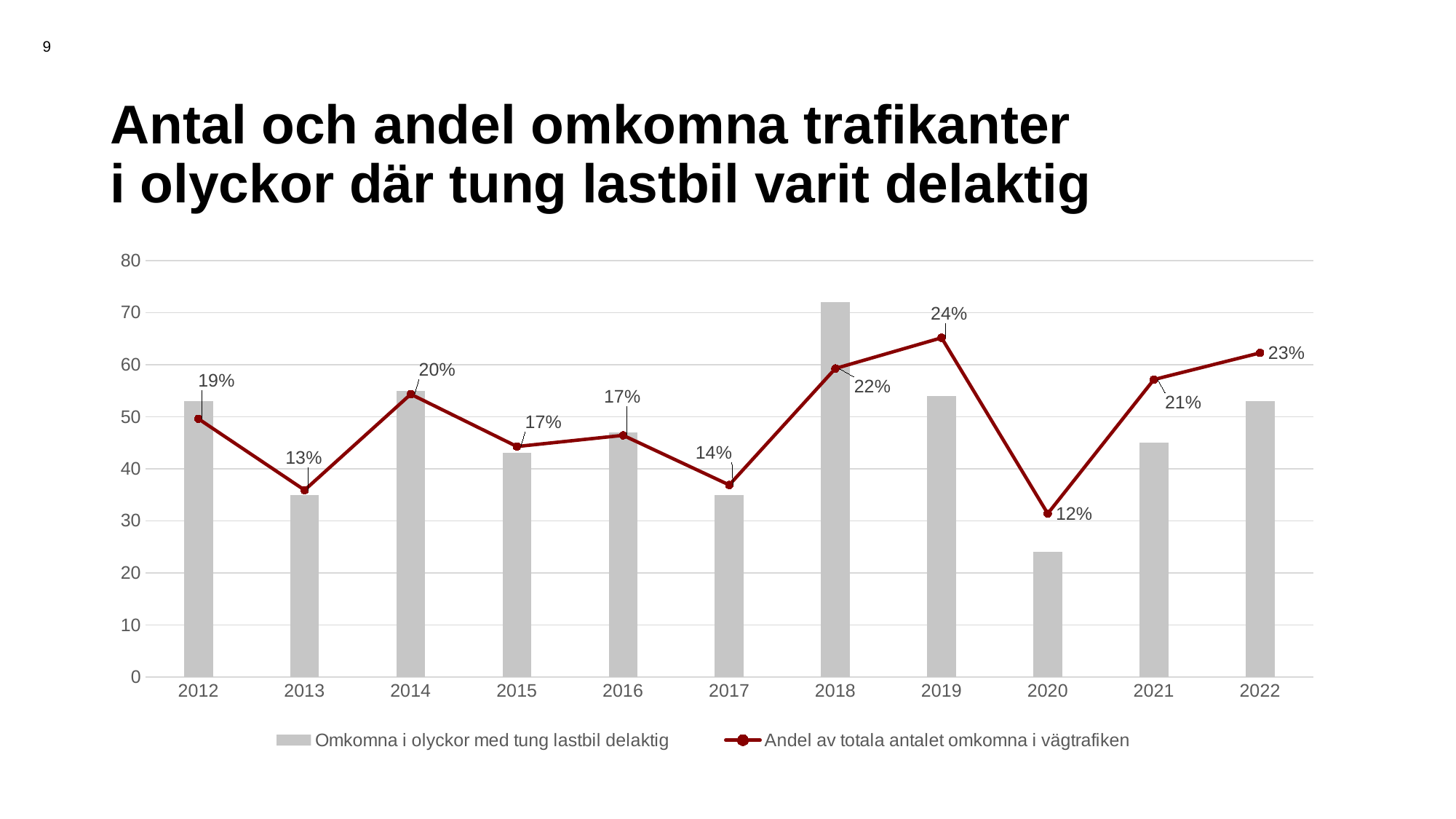
In which year is the share (Andel av totala antalet omkomna i vägtrafiken) lowest? 2020 In which year is the share (Andel av totala antalet omkomna i vägtrafiken) highest? 2019 Is the bar value for 2020 (Omkomna i olyckor med tung lastbil delaktig) greater or less than 30? less By how many percentage points does the share in 2022 exceed the share in 2013? 10 percentage points How many years are shown on the x axis? 11 Which year has the tallest bar for Omkomna i olyckor med tung lastbil delaktig? 2018 How many series does the legend list? 2 What kind of chart is shown on the slide? Combination bar and line chart Is the bar value for 2018 (Omkomna i olyckor med tung lastbil delaktig) greater or less than 60? greater What share of the total number of road traffic deaths (Andel av totala antalet omkomna i vägtrafiken) is shown for 2019? 24% Which year has the larger share value, 2014 or 2017? 2014 What is the value of the line series for 2020? 12%